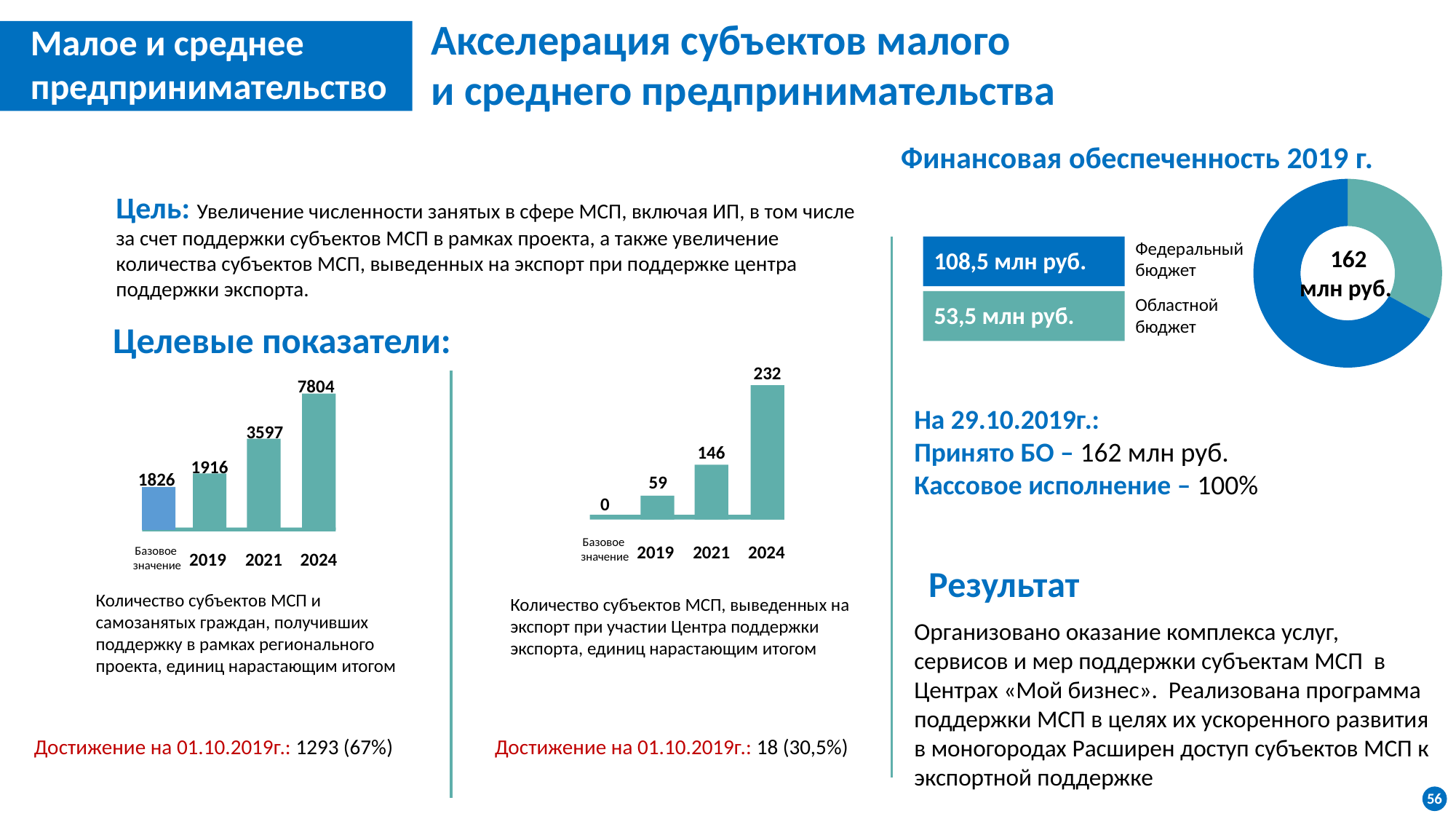
In the left bar chart (Количество субъектов МСП и самозанятых граждан), how many bars are shown? 4 In the middle bar chart (Количество субъектов МСП, выведенных на экспорт), which category has the highest value? 2024 In the left bar chart (Количество субъектов МСП и самозанятых граждан), which category has the lowest value? Базовое значение In the left bar chart (Количество субъектов МСП и самозанятых граждан), what is the difference between the 2024 and 2021 values? 4207 In the middle bar chart (Количество субъектов МСП, выведенных на экспорт), do the values rise or fall from Базовое значение to 2024? rise In the left bar chart (Количество субъектов МСП и самозанятых граждан), what is the value for Базовое значение? 1826 In the chart titled Финансовая обеспеченность 2019 г., what is the value for Федеральный бюджет? 108,5 млн руб. In the middle bar chart (Количество субъектов МСП, выведенных на экспорт), what is the value for Базовое значение? 0 In the middle bar chart (Количество субъектов МСП, выведенных на экспорт), what is the difference between the 2024 and 2019 values? 173 In the left bar chart (Количество субъектов МСП и самозанятых граждан), what is the value for 2024? 7804 What kind of chart is used for Финансовая обеспеченность 2019 г.? pie (donut) chart In the middle bar chart (Количество субъектов МСП, выведенных на экспорт), what is the value for 2021? 146